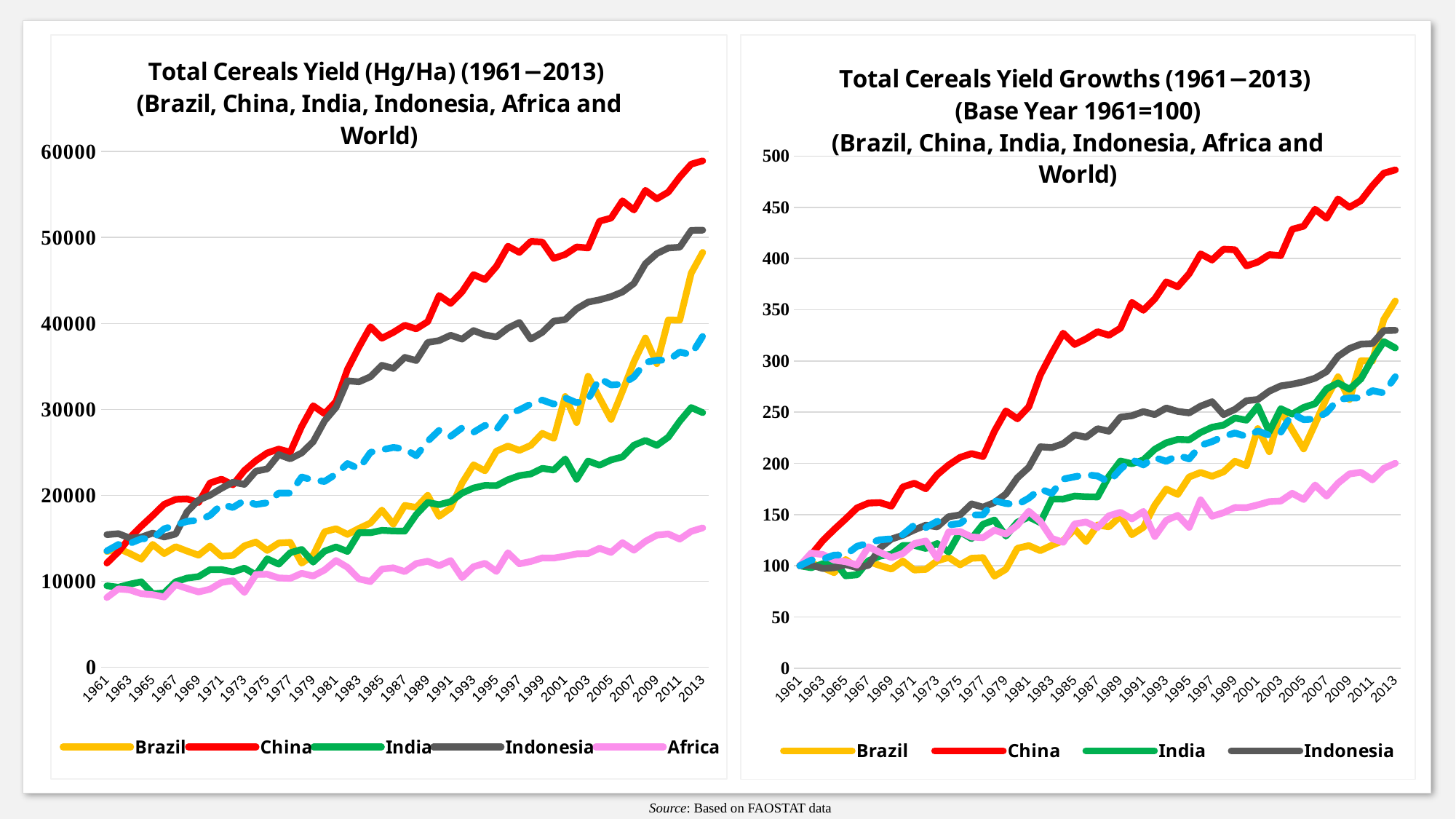
How many series does the legend of the right chart list? 4 In the left chart, which is larger in 2013, the value for China or the value for India? China In the right chart, which country shows the highest growth index in 2013? China In the left chart, is the value for Africa in 2013 greater or less than 20000? less In the left chart, which country has the highest cereals yield in 2013? China In the left chart, does the cereals yield for China rise or fall from 1961 to 2013? Rise In the left chart, is the value for China in 2013 greater or less than 50000? greater In the right chart, is the value for China in 2013 greater or less than 450? greater In the left chart, which legend series has the lowest cereals yield in 2013? Africa How many series does the legend of the left chart list? 5 What kind of chart is the left chart, 'Total Cereals Yield (Hg/Ha) (1961–2013)'? Line chart What kind of chart is the right chart, 'Total Cereals Yield Growths (1961–2013)'? Line chart